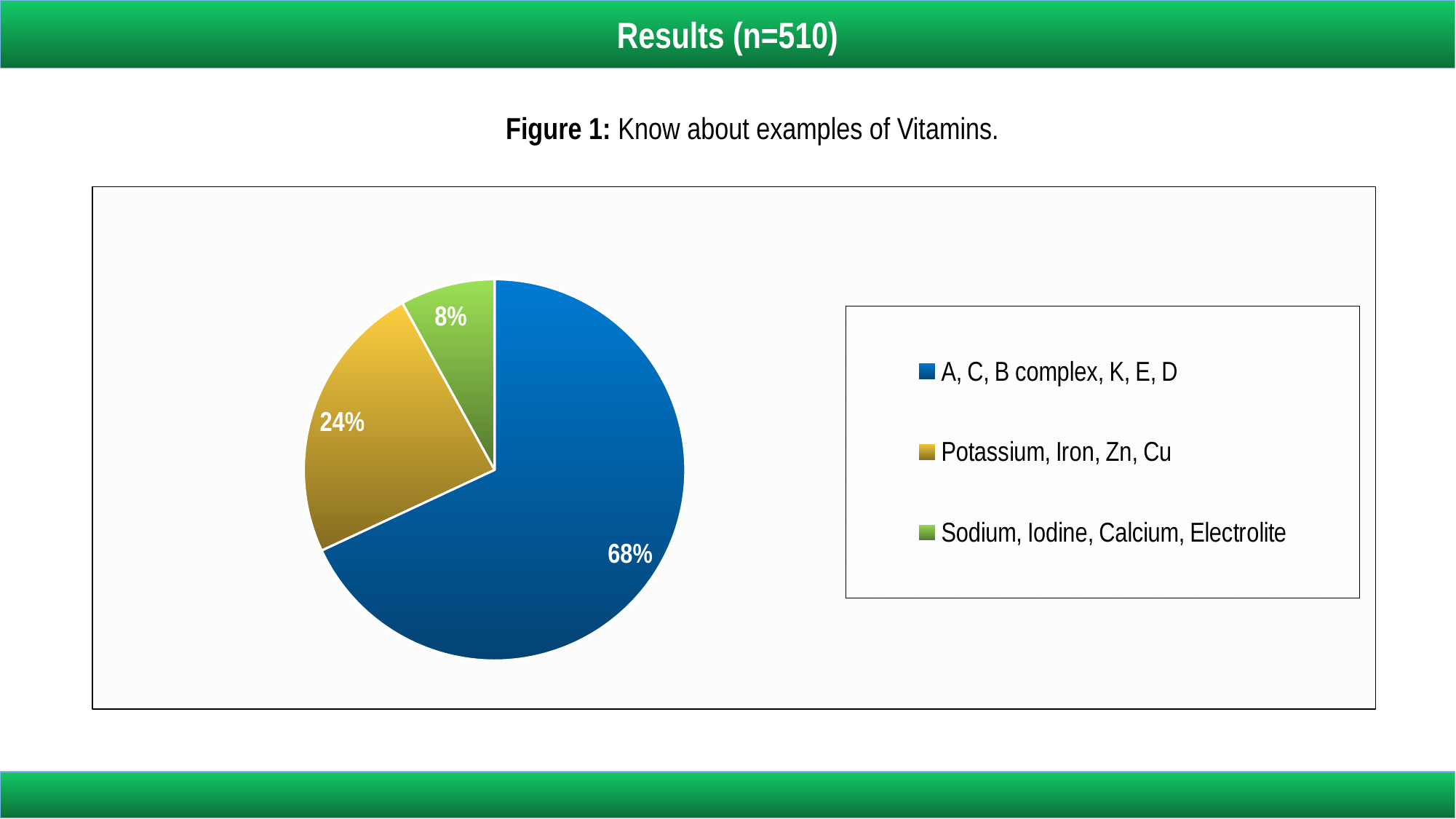
How many entries does the legend list? 3 Which slice is larger: 'Potassium, Iron, Zn, Cu' or 'Sodium, Iodine, Calcium, Electrolite'? Potassium, Iron, Zn, Cu Which category has the largest slice of the pie? A, C, B complex, K, E, D What is the title of the figure shown on the slide? Figure 1: Know about examples of Vitamins. What kind of chart is shown on the slide? Pie chart What is the difference in percentage points between the 'A, C, B complex, K, E, D' slice and the 'Potassium, Iron, Zn, Cu' slice? 44 Which category has the smallest slice of the pie? Sodium, Iodine, Calcium, Electrolite What percentage of the pie is labelled for 'A, C, B complex, K, E, D'? 68% What percentage of the pie is labelled for 'Potassium, Iron, Zn, Cu'? 24% How many slices does the pie chart have? 3 What percentage of the pie is labelled for 'Sodium, Iodine, Calcium, Electrolite'? 8% What colour is the slice for 'Potassium, Iron, Zn, Cu'? Gold/yellow